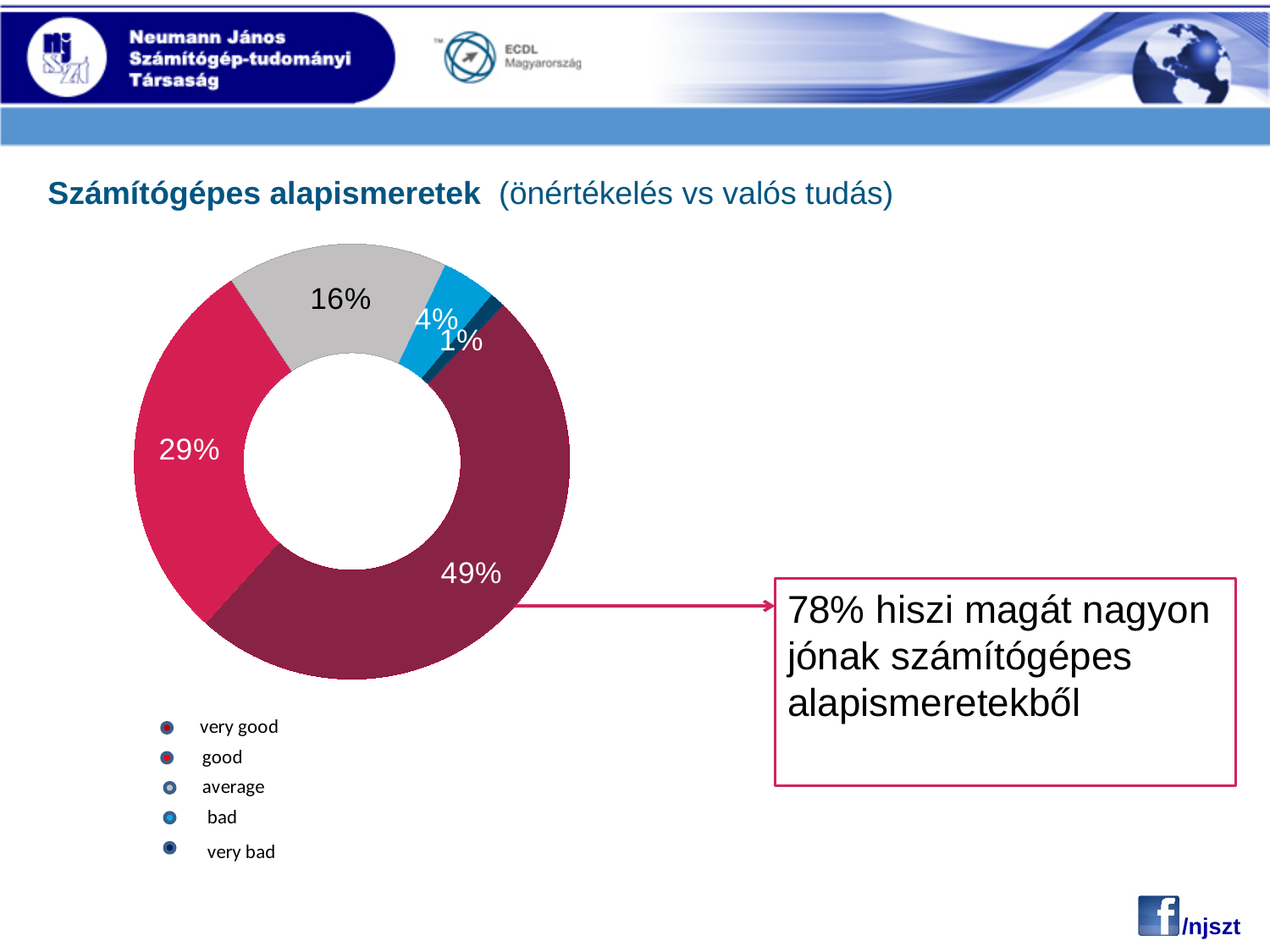
Which category has the largest share of the doughnut chart? very good Which category has the smallest share of the doughnut chart? very bad What kind of chart is shown on the slide? Doughnut (pie) chart How many slices does the doughnut chart have? 5 How many entries does the legend list? 5 What percentage is shown for the 'average' slice? 16% What percentage is shown for the 'good' slice? 29% What is the combined share of the 'very good' and 'good' slices? 78% What percentage is shown for the 'bad' slice? 4% What percentage is shown for the 'very bad' slice? 1% What percentage is shown for the 'very good' slice? 49% What is the difference in percentage points between the 'very good' and 'good' slices? 20